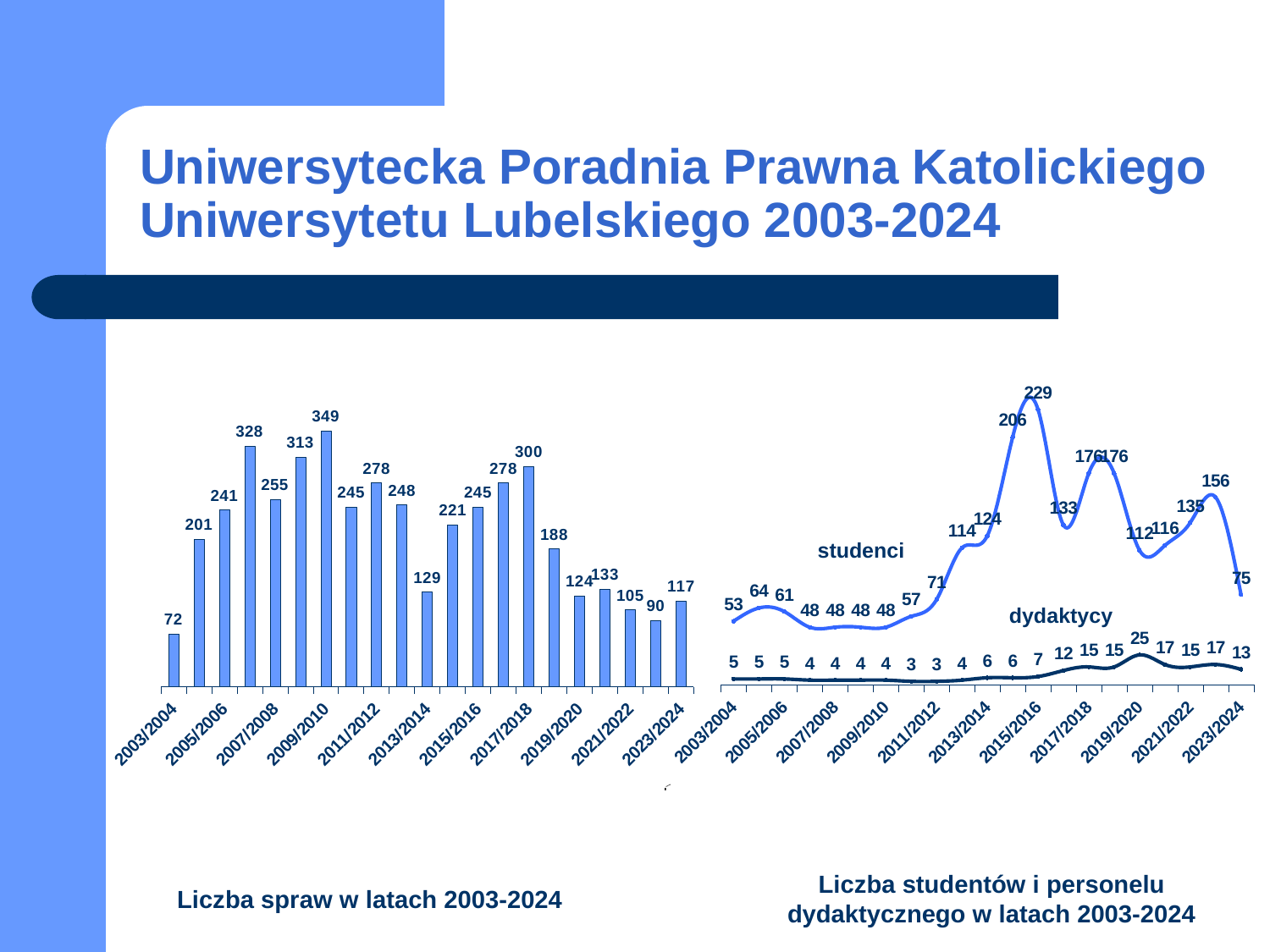
In the chart 'Liczba spraw w latach 2003-2024', which year has the lowest value? 2003/2004 In the chart 'Liczba studentów i personelu dydaktycznego w latach 2003-2024', what is the difference between the studenci and dydaktycy values for 2023/2024? 62 In the chart 'Liczba spraw w latach 2003-2024', what is the difference between the values for 2017/2018 and 2019/2020? 176 In the chart 'Liczba spraw w latach 2003-2024', which year has the highest value? 2009/2010 In the chart 'Liczba studentów i personelu dydaktycznego w latach 2003-2024', what is the value of the studenci series for 2015/2016? 229 In the chart 'Liczba studentów i personelu dydaktycznego w latach 2003-2024', which year has the highest value for the dydaktycy series? 2019/2020 In the chart 'Liczba spraw w latach 2003-2024', what is the value for 2009/2010? 349 In the chart 'Liczba studentów i personelu dydaktycznego w latach 2003-2024', what is the value of the dydaktycy series for 2019/2020? 25 In the chart 'Liczba studentów i personelu dydaktycznego w latach 2003-2024', which is larger: the studenci value for 2003/2004 or for 2023/2024? 2023/2024 What kind of chart is 'Liczba spraw w latach 2003-2024'? bar chart In the chart 'Liczba studentów i personelu dydaktycznego w latach 2003-2024', how many series are plotted? 2 In the chart 'Liczba spraw w latach 2003-2024', what is the value for 2023/2024? 117